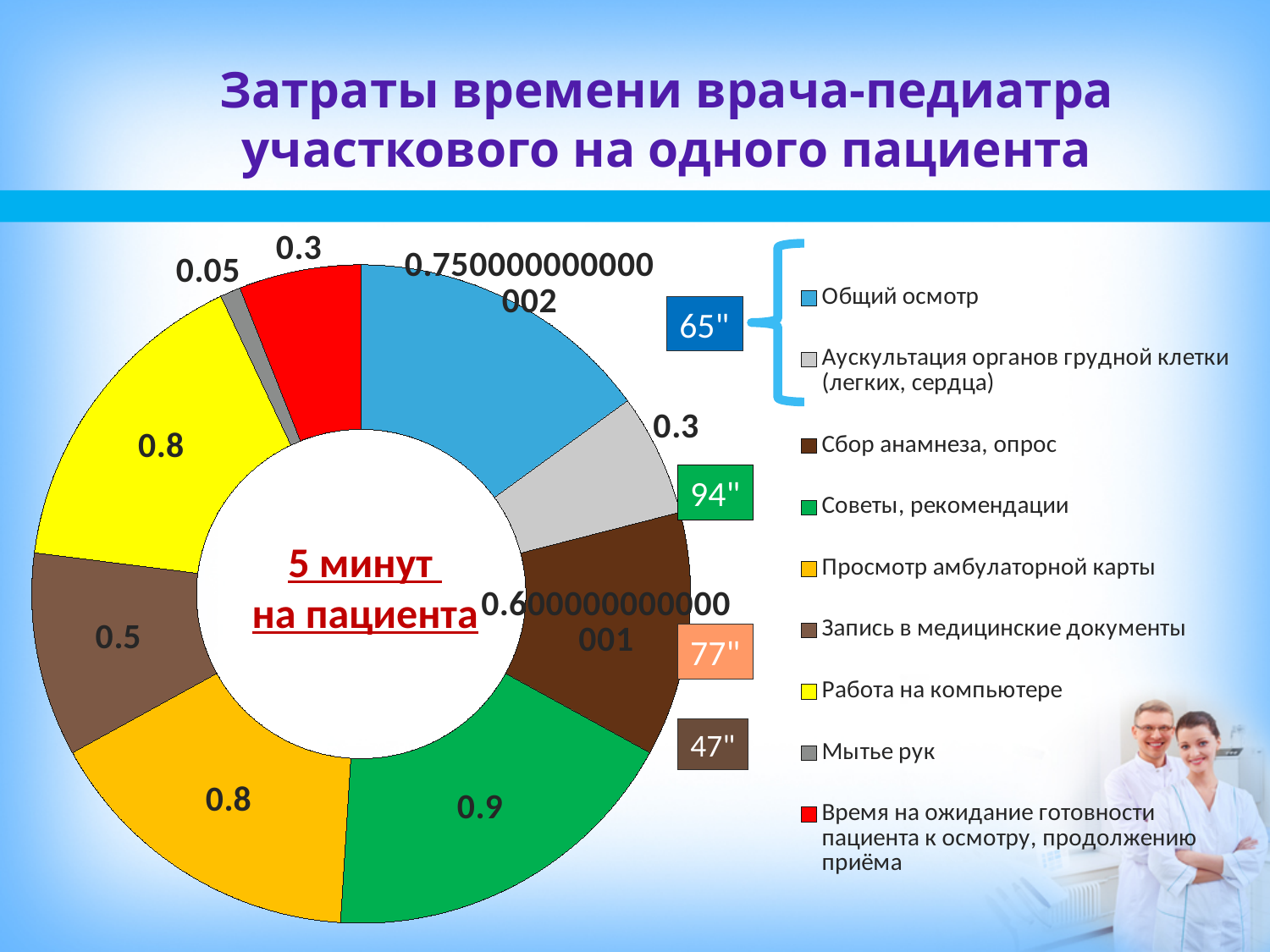
What is the value shown for the slice "Мытье рук"? 0.05 What type of chart is shown on the slide? Doughnut (pie) chart What is the value shown for the slice "Советы, рекомендации"? 0.9 What is the value shown for the slice "Аускультация органов грудной клетки (легких, сердца)"? 0.3 Which category has the smallest slice in the chart? Мытье рук What is the value shown for the slice "Запись в медицинские документы"? 0.5 Which category has the largest slice in the chart? Советы, рекомендации Which is larger: the value for "Советы, рекомендации" or the value for "Запись в медицинские документы"? Советы, рекомендации What is the difference between the values for "Работа на компьютере" and "Запись в медицинские документы"? 0.3 What is the difference between the values for "Советы, рекомендации" and "Просмотр амбулаторной карты"? 0.1 How many categories does the legend of the chart list? 9 What text is written in the centre of the doughnut chart? 5 минут на пациента